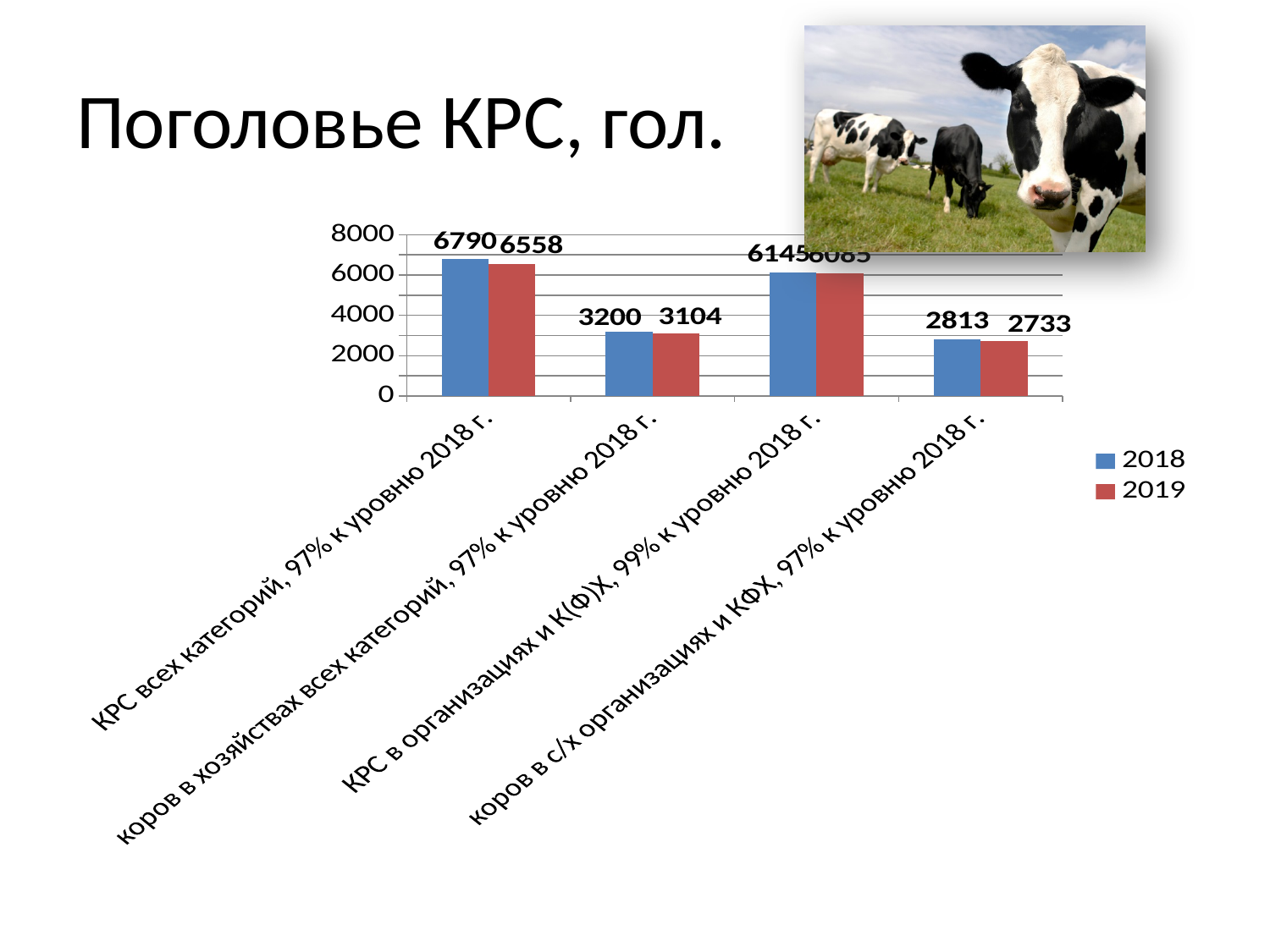
What is the difference between the 2018 and 2019 values for 'КРС всех категорий, 97% к уровню 2018 г.'? 232 What kind of chart is shown on the slide? bar chart What is the 2019 value for 'коров в с/х организациях и КФХ, 97% к уровню 2018 г.'? 2733 What is the 2018 value for 'коров в хозяйствах всех категорий, 97% к уровню 2018 г.'? 3200 How many series does the legend list? 2 Which category has the highest 2018 value? КРС всех категорий, 97% к уровню 2018 г. Which category has the lowest 2019 value? коров в с/х организациях и КФХ, 97% к уровню 2018 г. What is the 2019 value for 'коров в хозяйствах всех категорий, 97% к уровню 2018 г.'? 3104 What is the 2018 value for 'КРС в организациях и К(Ф)Х, 99% к уровню 2018 г.'? 6145 What is the 2019 value for 'КРС всех категорий, 97% к уровню 2018 г.'? 6558 What is the difference between the 2018 and 2019 values for 'коров в с/х организациях и КФХ, 97% к уровню 2018 г.'? 80 What is the 2018 value for 'КРС всех категорий, 97% к уровню 2018 г.'? 6790